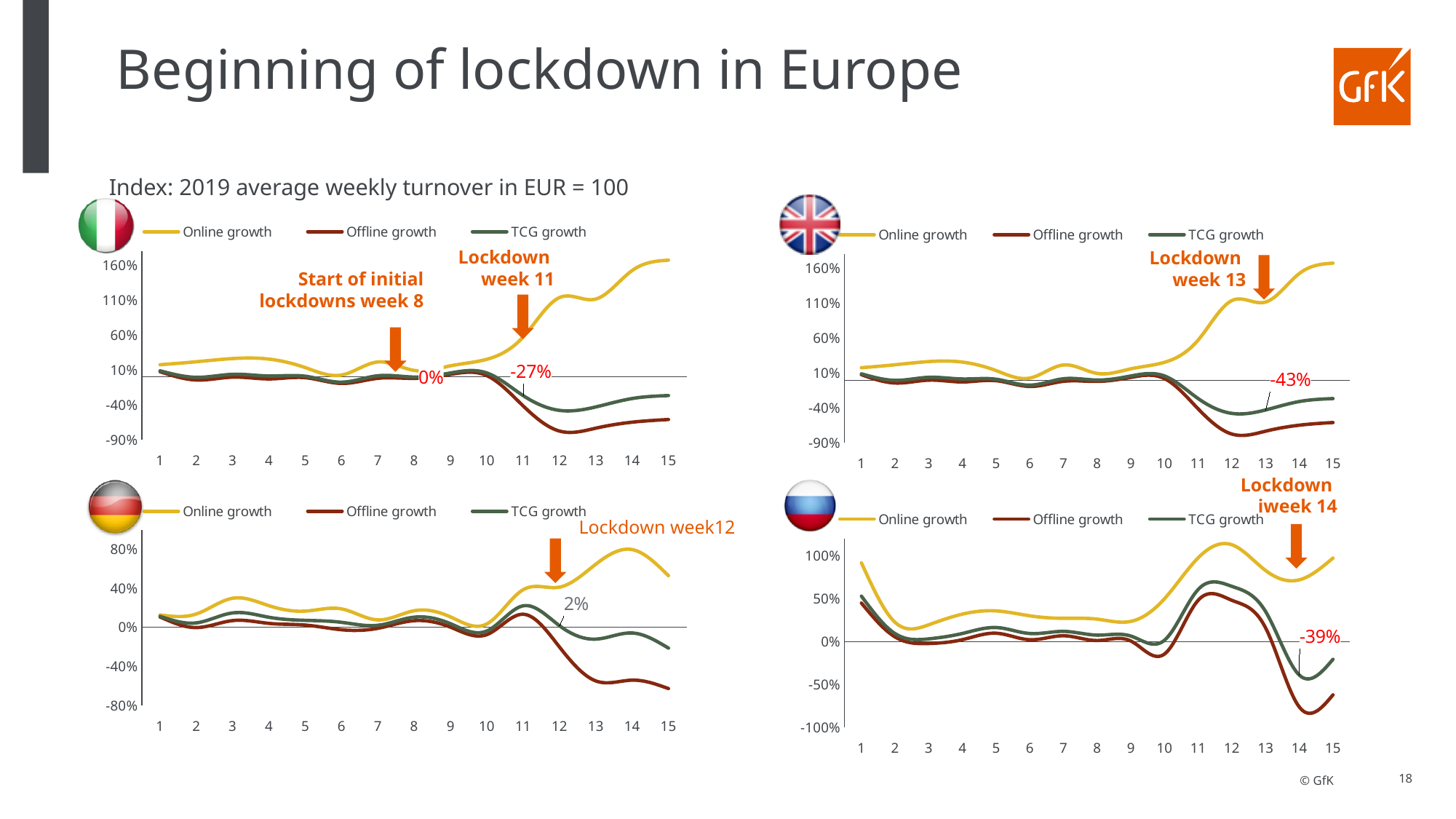
In the top-left chart, what value is labelled for TCG growth at week 11? -27% In the bottom-right chart, what value is labelled for TCG growth at week 14? -39% In the bottom-right chart, which series has the lowest value at week 14? Offline growth In the top-right chart, is the value for Offline growth at week 12 greater or less than -40%? less How many series does the legend of the top-left chart list? 3 How many weeks are plotted along the x axis of the bottom-left chart? 15 In the top-left chart, does Online growth rise or fall from week 9 to week 15? rise In the top-left chart, is the value for Online growth at week 15 greater or less than 110%? greater In the bottom-left chart, what value is labelled for TCG growth at week 12? 2% What kind of chart is the top-left chart on the slide? line chart In the top-right chart, what value is labelled for TCG growth at week 13? -43% In the bottom-left chart, which series is larger at week 15, Online growth or Offline growth? Online growth